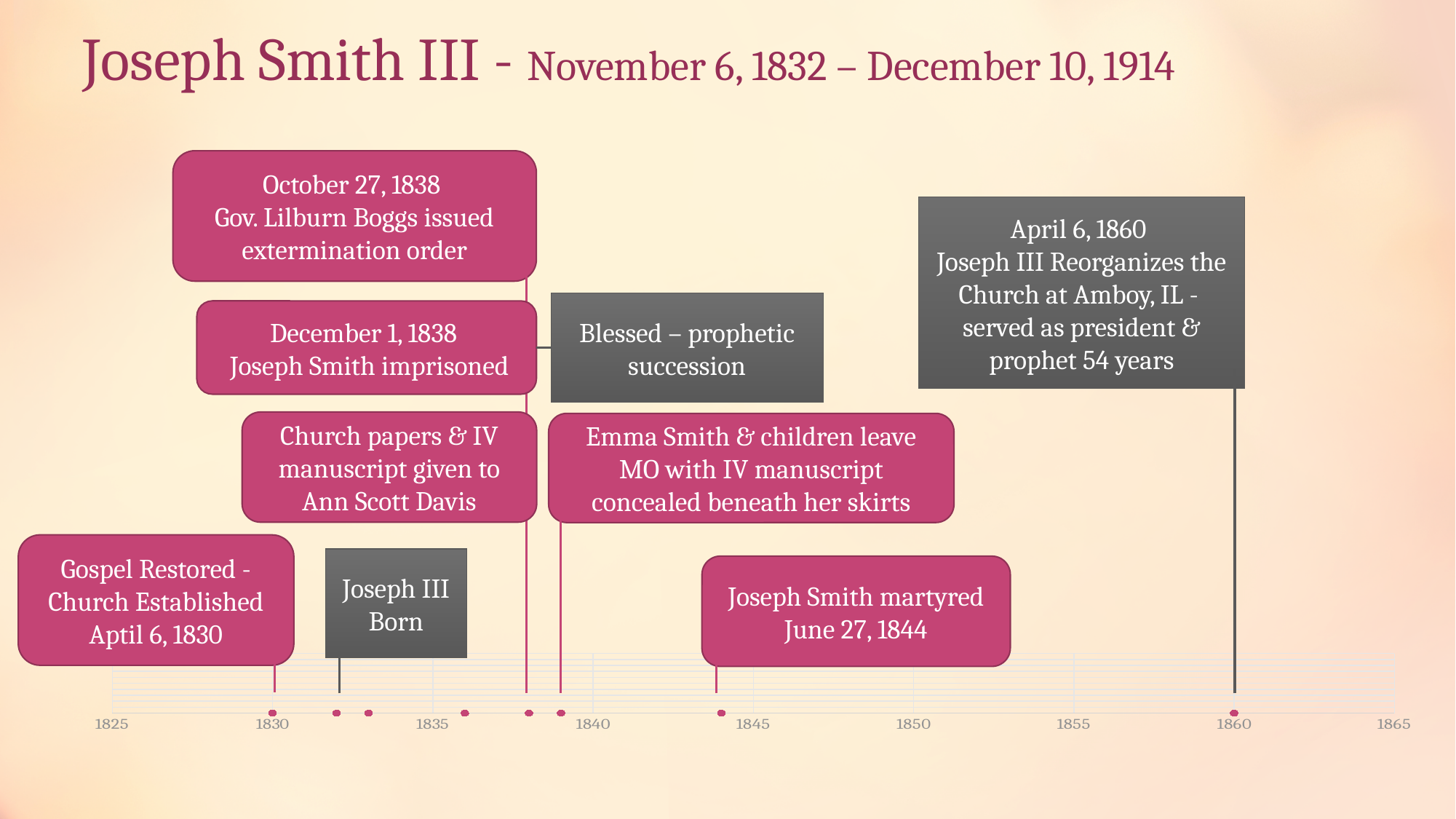
Which event on the timeline is the latest? Joseph III Reorganizes the Church at Amboy, IL Is the year when Emma Smith & children left MO greater or less than 1840? less How many event markers are plotted along the timeline axis? 8 What is the earliest year labeled on the timeline's axis? 1825 How many years passed between Joseph Smith's martyrdom and Joseph III reorganizing the Church? 16 On what date did Gov. Lilburn Boggs issue the extermination order? October 27, 1838 On what date did Joseph III reorganize the Church at Amboy, IL? April 6, 1860 In what year was Joseph Smith martyred according to the timeline? 1844 What kind of chart is shown on the slide? Timeline chart Which happened first, Joseph Smith being imprisoned or Joseph Smith being martyred? Joseph Smith imprisoned Which event on the timeline is the earliest? Gospel Restored - Church Established What is the latest year labeled on the timeline's axis? 1865